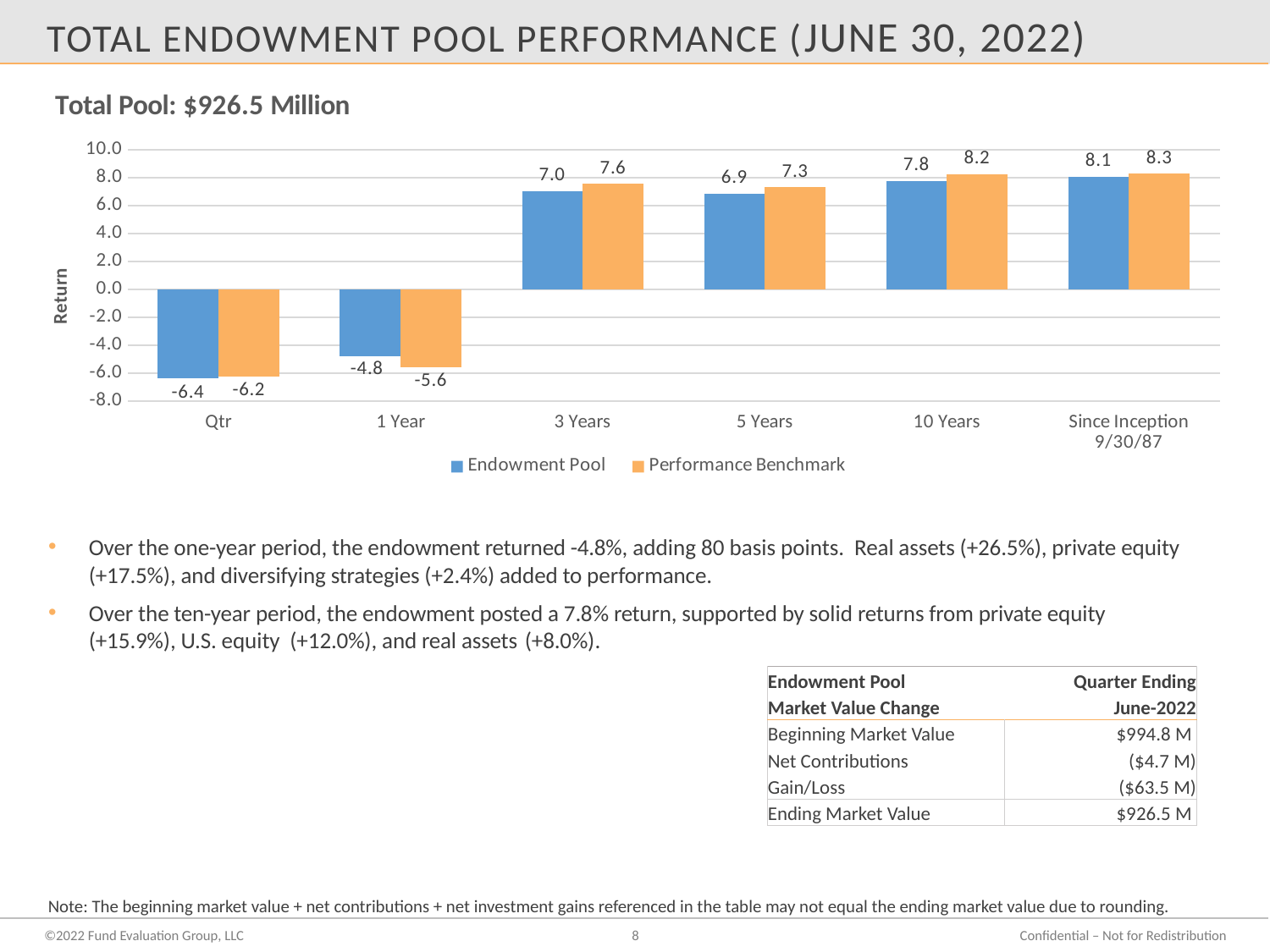
What is the Endowment Pool return for the 1 Year period? -4.8 What is the Performance Benchmark return for the 10 Years period? 8.2 What is the Endowment Pool return for the Qtr period? -6.4 What type of chart is shown on the slide? Bar chart Which period has the lowest Performance Benchmark return? Qtr How many series does the chart legend list? 2 How many time periods are shown on the x axis of the chart? 6 What is the difference between the Performance Benchmark and Endowment Pool returns for the 1 Year period? 0.8 Which is larger for the 3 Years period, the Endowment Pool return or the Performance Benchmark return? Performance Benchmark What is the label of the y axis of the chart? Return Is the Endowment Pool return for 5 Years greater or less than 6.0? greater Which period has the highest Endowment Pool return? Since Inception 9/30/87